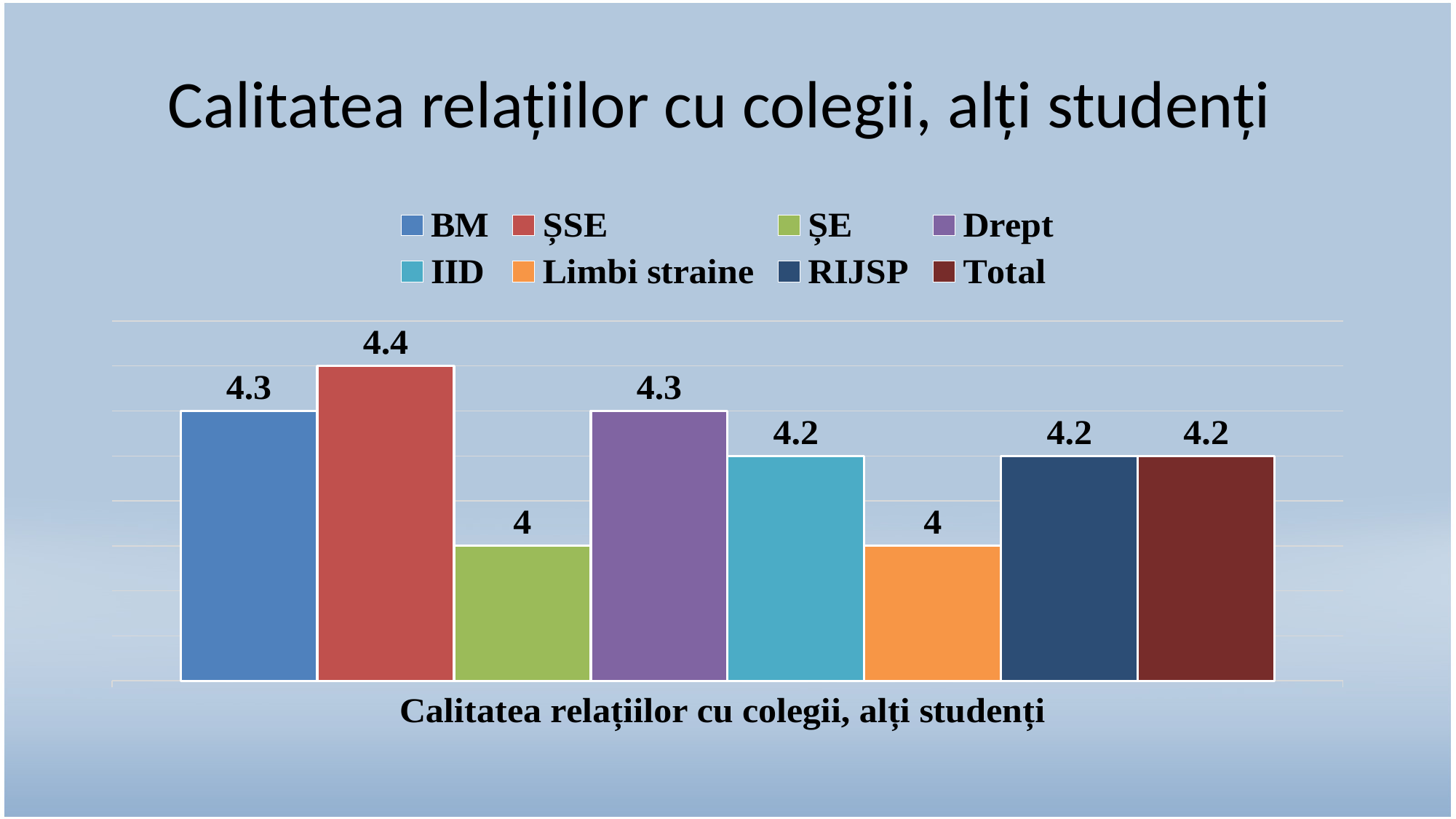
What is the difference between the values for BM and IID? 0.1 What is the value for ȘSE? 4.4 Which is larger, the value for BM or the value for RIJSP? BM What is the title of the slide? Calitatea relațiilor cu colegii, alți studenți What kind of chart is shown on the slide? Bar chart Which is larger, the value for ȘE or the value for Drept? Drept Which series has the highest value? ȘSE What is the value for Drept? 4.3 What is the value for Limbi straine? 4 How many series does the legend list? 8 What is the difference between the values for ȘSE and ȘE? 0.4 What is the value for Total? 4.2